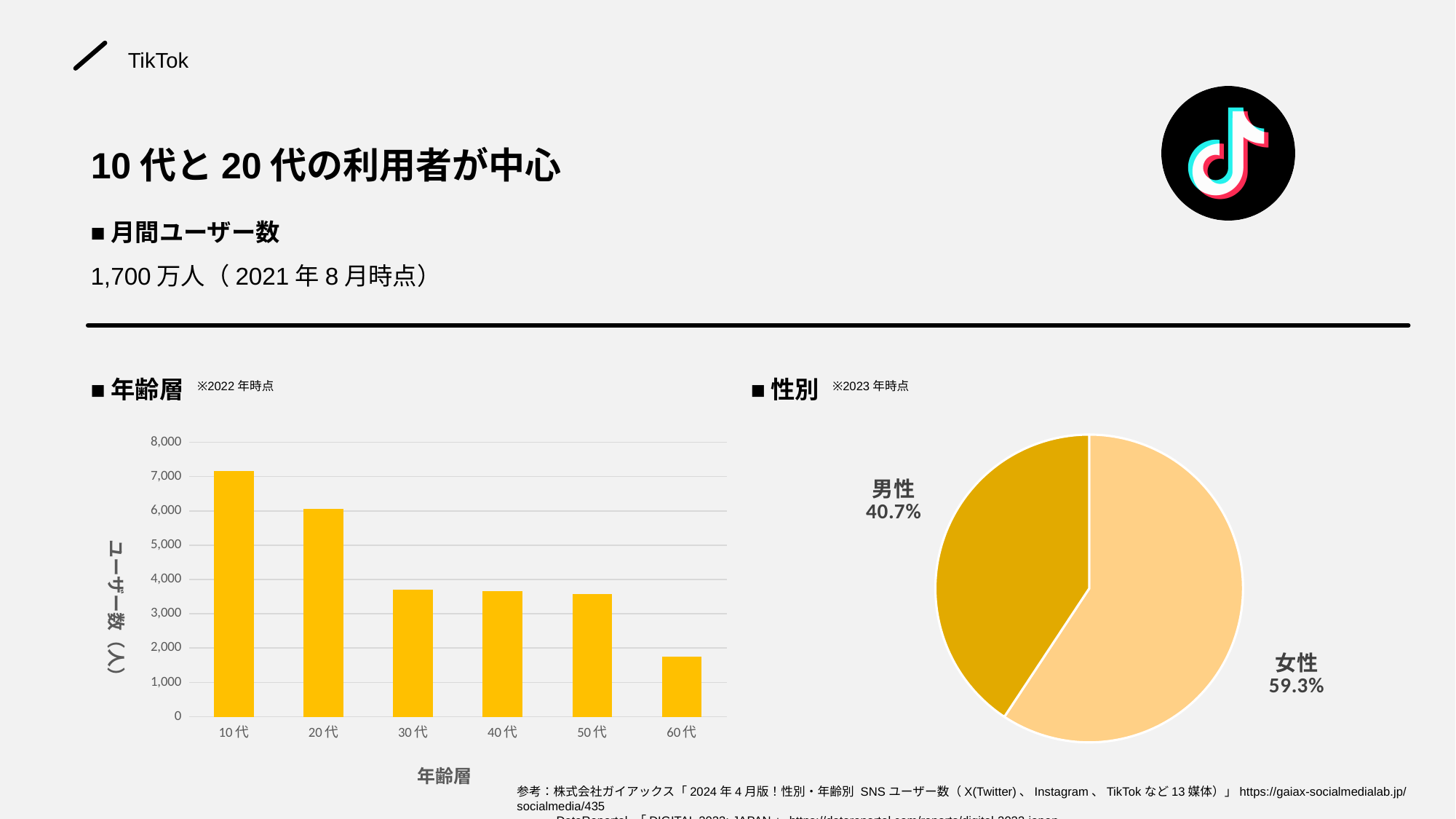
In the 年齢層 bar chart, is the value for 60代 greater or less than 2,000? less What kind of chart is the 年齢層 chart on the left? bar chart In the 年齢層 bar chart, which has more users, 10代 or 20代? 10代 In the 性別 pie chart, what share is 女性? 59.3% In the 年齢層 bar chart, which age group has the lowest number of users? 60代 In the 年齢層 bar chart, how many age-group categories are shown? 6 In the 年齢層 bar chart, is the value for 10代 greater or less than 6,000? greater In the 性別 pie chart, what share is 男性? 40.7% In the 年齢層 bar chart, which age group has the highest number of users? 10代 In the 年齢層 bar chart, do the values generally rise or fall from 10代 to 60代? fall In the 年齢層 bar chart, is the value for 30代 greater or less than 3,000? greater What kind of chart is the 性別 chart on the right? pie chart